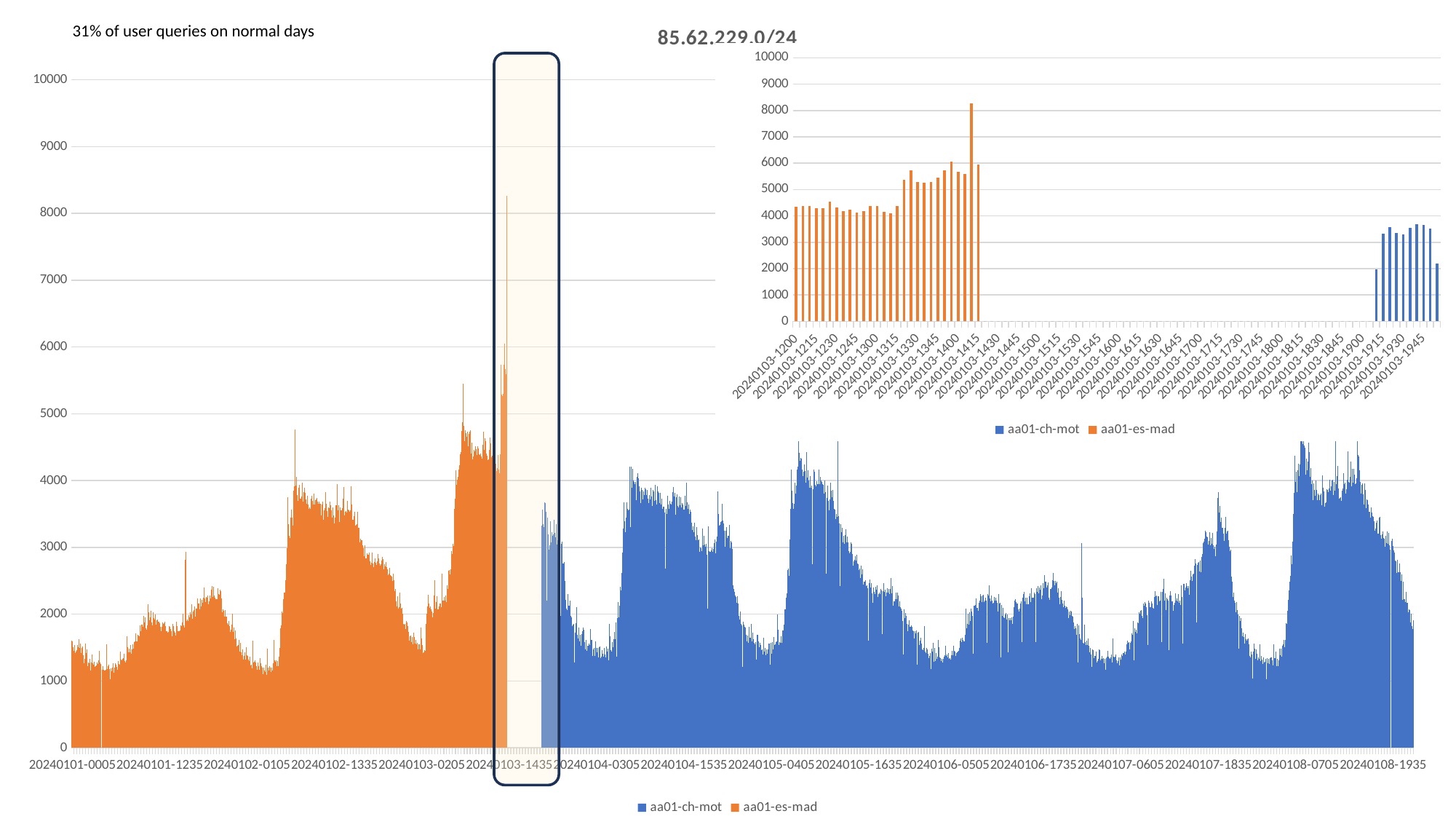
How many series does the legend of the inset chart titled 85.62.229.0/24 list? 2 In the large chart on the left, is the highest value reached by aa01-ch-mot greater or less than 5000? less In the inset chart titled 85.62.229.0/24, is the value for aa01-ch-mot at 20240103-1930 greater or less than 4000? less In the inset chart titled 85.62.229.0/24, which series reaches the higher peak value? aa01-es-mad What kind of chart is the inset chart titled 85.62.229.0/24? bar chart In the inset chart titled 85.62.229.0/24, which is larger: the aa01-es-mad value at 20240103-1415 or at 20240103-1200? 20240103-1415 In the inset chart titled 85.62.229.0/24, is the value for aa01-es-mad at 20240103-1200 greater or less than 5000? less What is the title of the inset chart in the top right of the slide? 85.62.229.0/24 In the large chart on the left, which series is shown in orange? aa01-es-mad